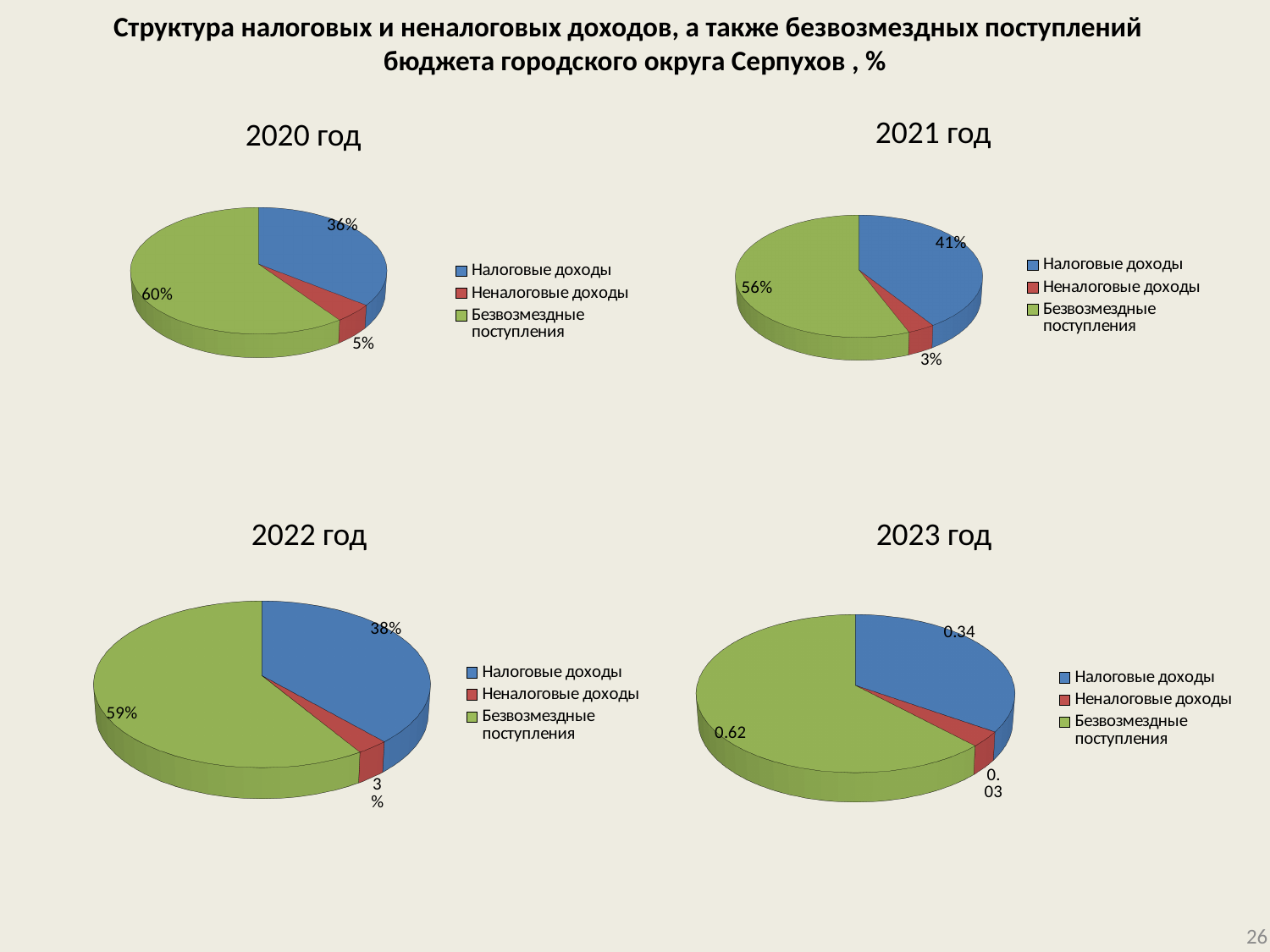
How many charts are on the slide? 4 How many categories does the "2020 год" chart show? 3 In the "2022 год" chart, which category has the smallest share? Неналоговые доходы In the "2022 год" chart, what is the difference between Безвозмездные поступления and Налоговые доходы? 21% In the "2020 год" chart, what is the value for Налоговые доходы? 36% What kind of chart is the "2022 год" chart? Pie chart In the "2021 год" chart, what is the value for Неналоговые доходы? 3% In the "2021 год" chart, which is larger: Налоговые доходы or Неналоговые доходы? Налоговые доходы In the "2023 год" chart, what is the value for Безвозмездные поступления? 0.62 In the "2023 год" chart, what is the value for Налоговые доходы? 0.34 In the "2021 год" chart, which category has the largest share? Безвозмездные поступления In the "2020 год" chart, what is the value for Безвозмездные поступления? 60%